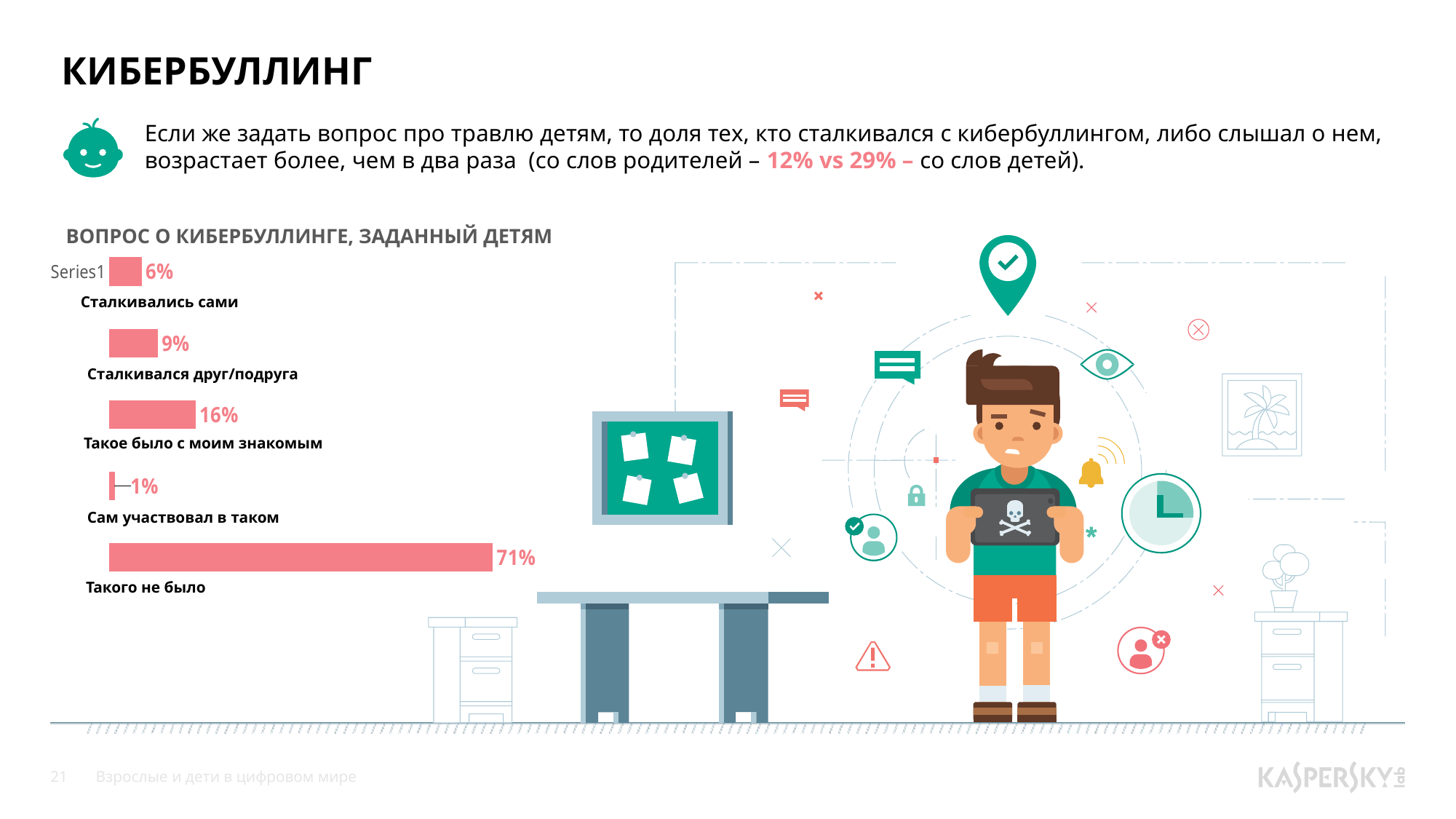
What is the value for "Сталкивался друг/подруга"? 9% How many categories are shown in the chart? 5 What is the value for "Такого не было"? 71% Which category has the lowest value? Сам участвовал в таком What is the value for "Сталкивались сами"? 6% Which category has the highest value? Такого не было What is the difference between the values for "Такое было с моим знакомым" and "Сталкивались сами"? 10% Which is larger: the value for "Сталкивался друг/подруга" or the value for "Сталкивались сами"? Сталкивался друг/подруга What is the title of the chart? ВОПРОС О КИБЕРБУЛЛИНГЕ, ЗАДАННЫЙ ДЕТЯМ What is the value for "Сам участвовал в таком"? 1% What is the value for "Такое было с моим знакомым"? 16% What type of chart is shown on the slide? Bar chart